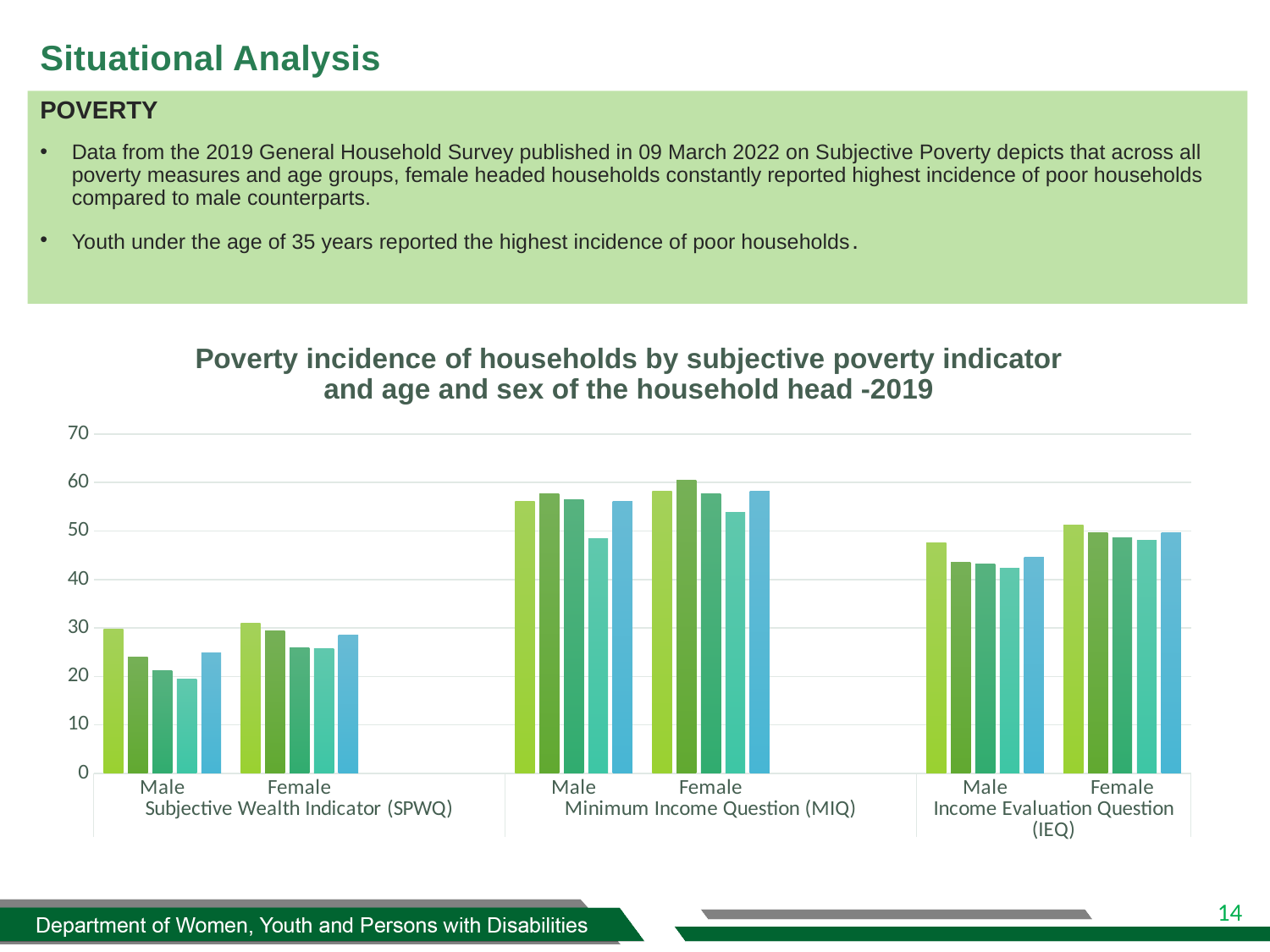
Is the tallest bar for Female under Minimum Income Question (MIQ) greater or less than 50? greater Which subjective poverty indicator group has the tallest bars overall? Minimum Income Question (MIQ) How many subjective poverty indicator groups are shown along the x axis? 3 Is the shortest bar for Male under Income Evaluation Question (IEQ) greater or less than 40? greater Under Income Evaluation Question (IEQ), which has the taller tallest bar, Male or Female? Female Is the tallest bar for Male under Subjective Wealth Indicator (SPWQ) greater or less than 40? less What kind of chart is shown on the slide? bar chart Which subjective poverty indicator group has the shortest bars overall? Subjective Wealth Indicator (SPWQ) What is the title of the chart? Poverty incidence of households by subjective poverty indicator and age and sex of the household head -2019 How many bars are plotted for each Male or Female category? 5 What is the highest value shown on the vertical axis? 70